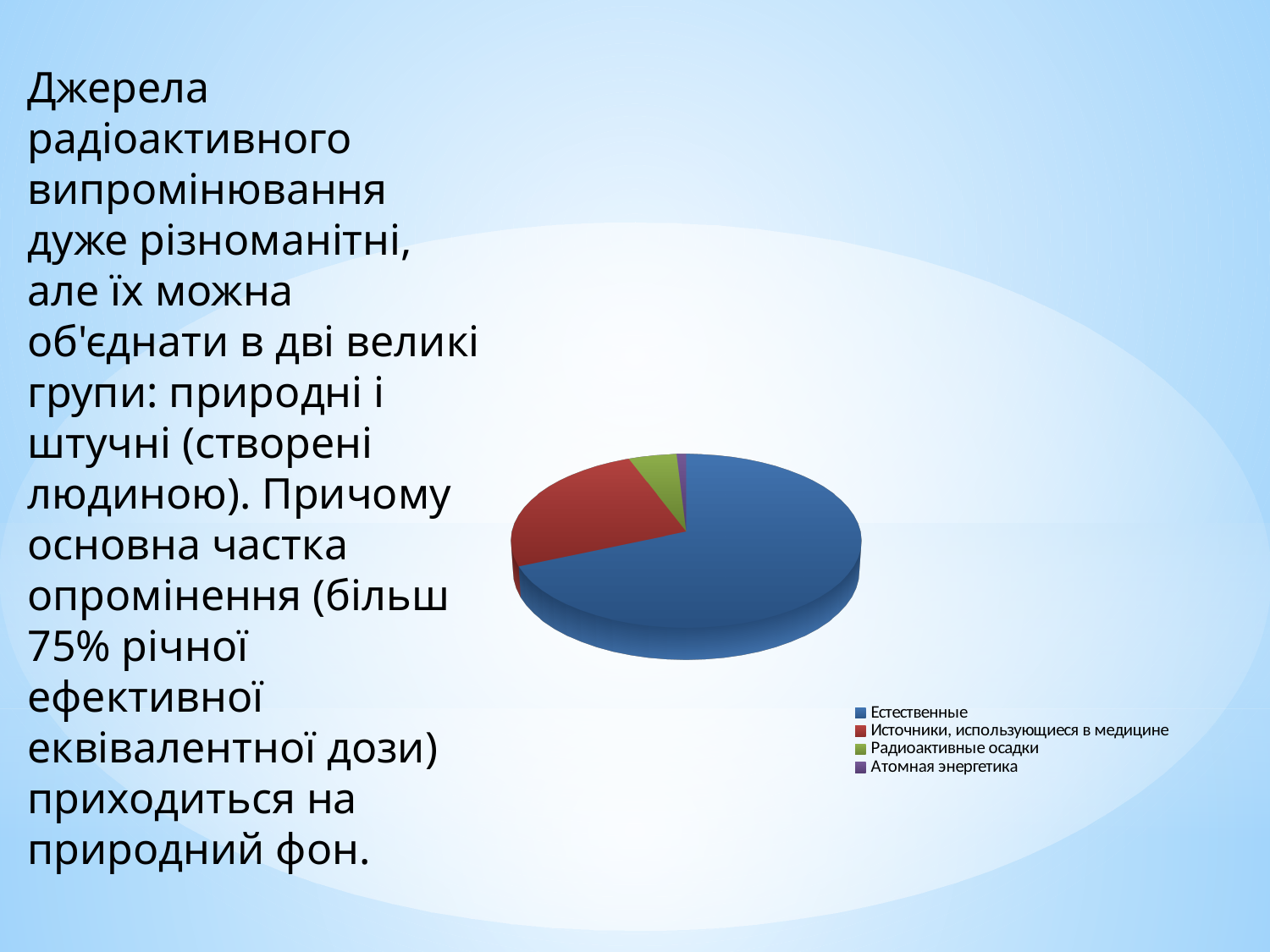
Which category has the smallest slice of the pie chart? Атомная энергетика Which category has the second-largest slice of the pie chart? Источники, использующиеся в медицине Which slice is larger: Источники, использующиеся в медицине or Радиоактивные осадки? Источники, использующиеся в медицине Which category has the largest slice of the pie chart? Естественные How many categories does the pie chart have? 4 Which slice is larger: Радиоактивные осадки or Атомная энергетика? Радиоактивные осадки Which category is shown in green in the pie chart? Радиоактивные осадки What colour is the slice for Естественные in the pie chart? blue Which slice is larger: Естественные or Источники, использующиеся в медицине? Естественные What kind of chart is shown on the slide? pie chart